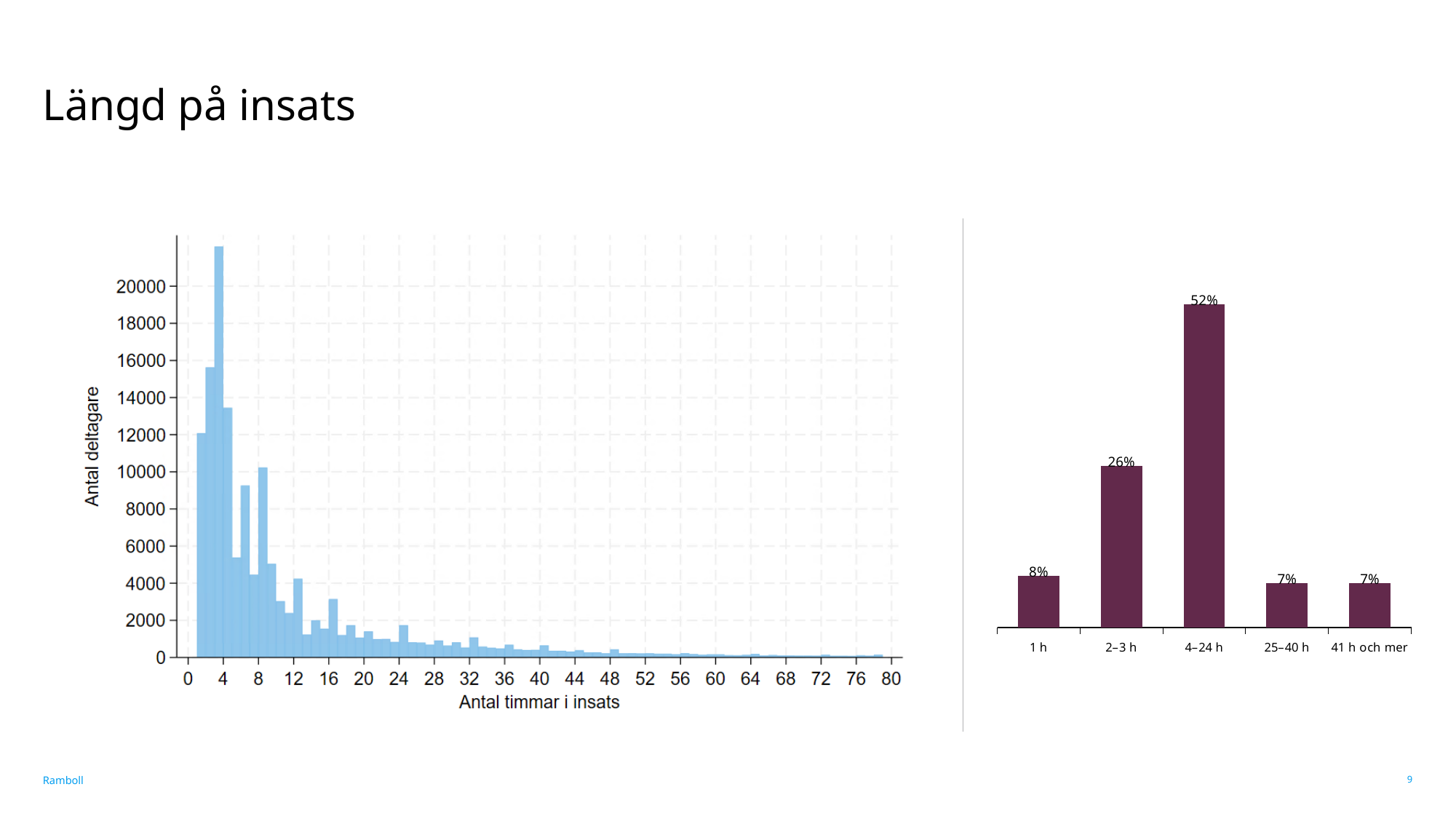
In the right-hand bar chart, what is the difference between the values for 4–24 h and 2–3 h? 26% In the right-hand bar chart, what is the value for 1 h? 8% In the right-hand bar chart, what is the value for 4–24 h? 52% In the right-hand bar chart, what is the value for 41 h och mer? 7% In the left-hand chart, do the values generally rise or fall as the number of hours increases beyond 4? fall What kind of chart is the left-hand chart? Bar chart (histogram) In the right-hand bar chart, which is larger, the value for 1 h or the value for 25–40 h? 1 h In the right-hand bar chart, what is the value for 2–3 h? 26% In the left-hand chart, is the value of the tallest bar greater or less than 20000? greater In the right-hand bar chart, which category has the highest value? 4–24 h How many categories are shown in the right-hand bar chart? 5 What is the label of the x axis of the left-hand chart? Antal timmar i insats